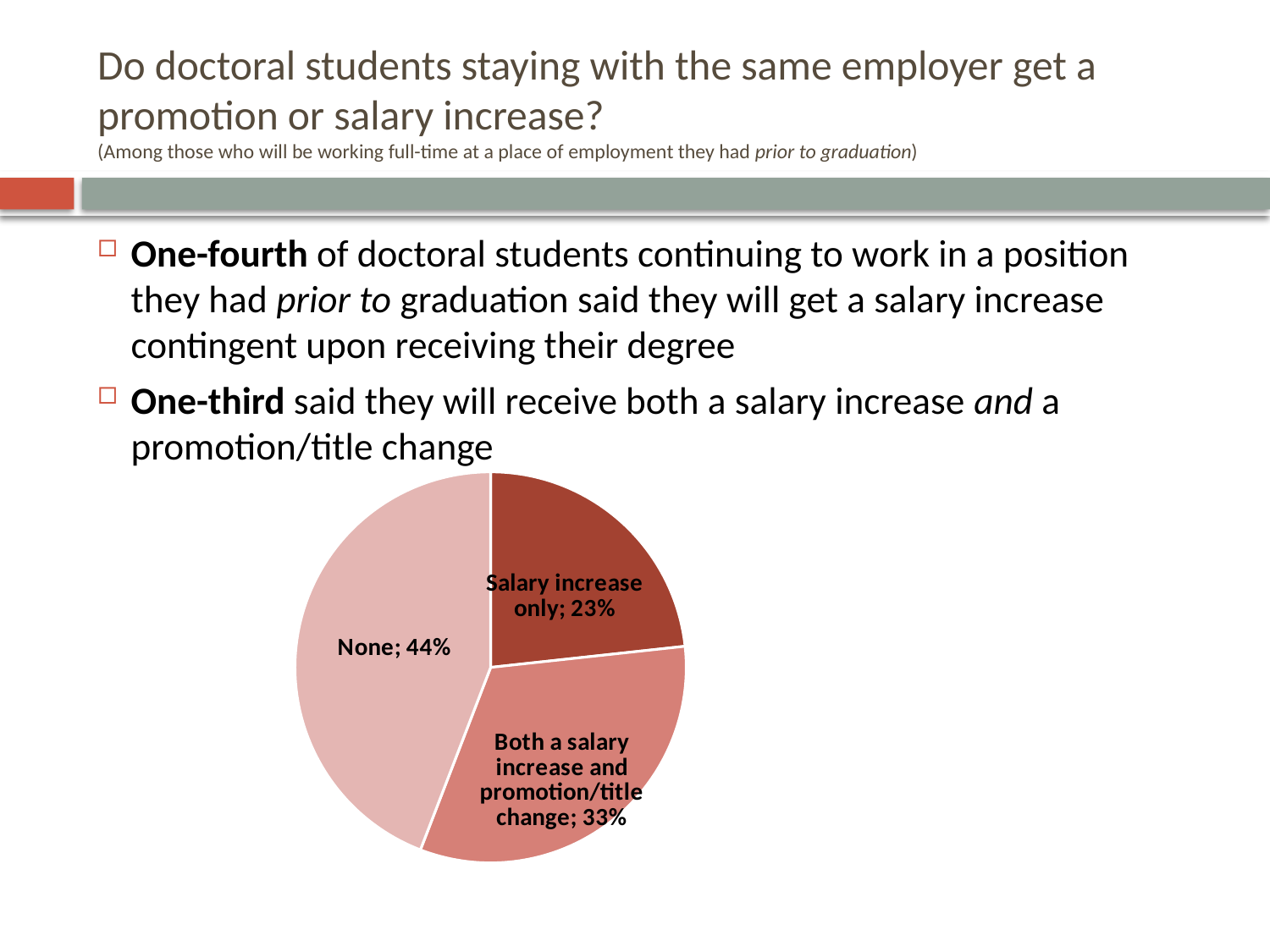
What is the difference in percentage points between the "None" slice and the "Salary increase only" slice? 21 Which slice of the pie is shown in the darkest red colour? Salary increase only What percentage of the pie is labelled "Both a salary increase and promotion/title change"? 33% What percentage of the pie is labelled "Salary increase only"? 23% Which is larger: the "Both a salary increase and promotion/title change" slice or the "Salary increase only" slice? Both a salary increase and promotion/title change How many slices does the pie chart have? 3 Which slice of the pie is the smallest? Salary increase only Is the "None" slice greater or less than 40%? greater Which slice of the pie is the largest? None What is the difference in percentage points between the "Both a salary increase and promotion/title change" slice and the "Salary increase only" slice? 10 What percentage of the pie is labelled "None"? 44% What kind of chart is shown on the slide? pie chart